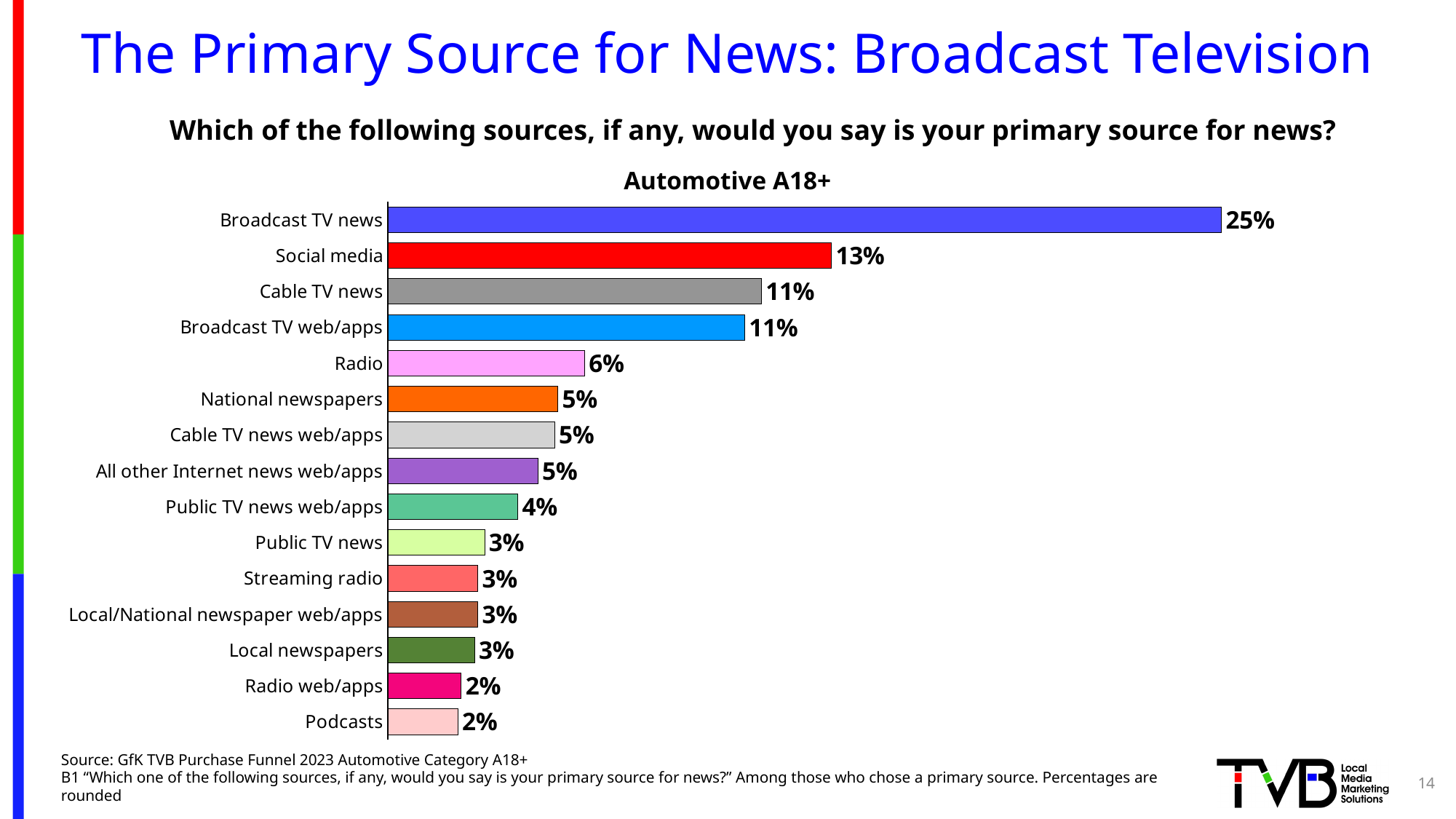
Which is larger, the value for Social media or the value for Cable TV news? Social media Which is larger, the value for Radio or the value for National newspapers? Radio What percentage is shown for Radio? 6% What is the value for Public TV news web/apps? 4% What is the value shown for Social media? 13% What is the difference between Cable TV news and Radio? 5 How many news sources (categories) are shown in the chart? 15 What percentage of respondents named Broadcast TV news as their primary source for news? 25% What type of chart is shown on the slide? Bar chart Which source has the highest percentage in the chart? Broadcast TV news What is the title printed above the chart? Automotive A18+ What is the difference in percentage points between Broadcast TV news and Social media? 12